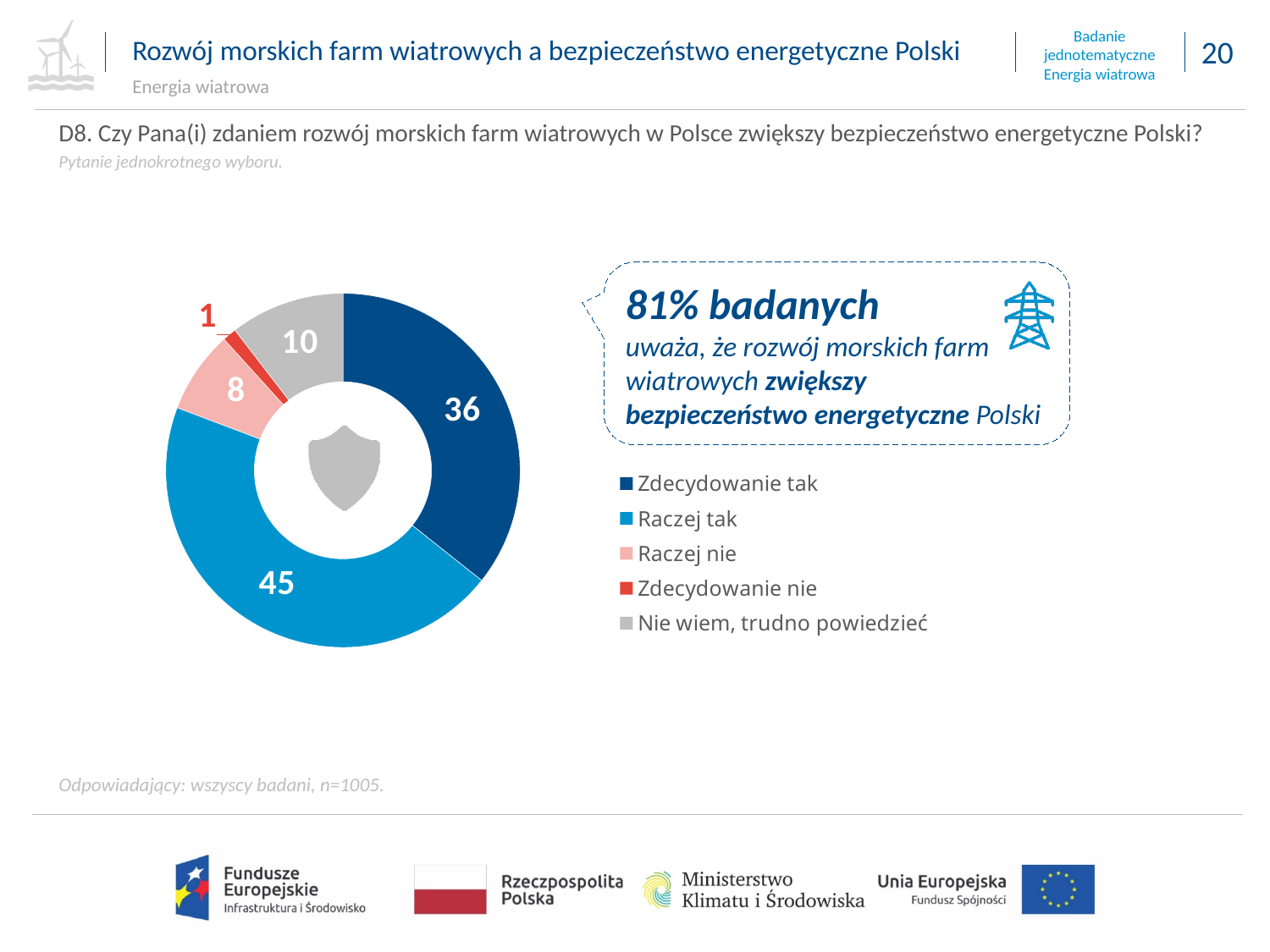
What is the value for "Nie wiem, trudno powiedzieć" in the chart? 10 Which category has the smallest share of the chart? Zdecydowanie nie Which is larger, the value for "Nie wiem, trudno powiedzieć" or the value for "Raczej nie"? Nie wiem, trudno powiedzieć What is the value for "Zdecydowanie tak" in the chart? 36 What colour is the "Zdecydowanie nie" slice in the chart? Red What is the value for "Raczej tak" in the chart? 45 Which category has the largest share of the chart? Raczej tak What is the combined value of "Zdecydowanie tak" and "Raczej tak"? 81 What kind of chart is shown on the slide? Pie chart (donut) What is the difference between the values for "Raczej tak" and "Zdecydowanie tak"? 9 How many categories does the legend of the chart list? 5 What is the value for "Raczej nie" in the chart? 8